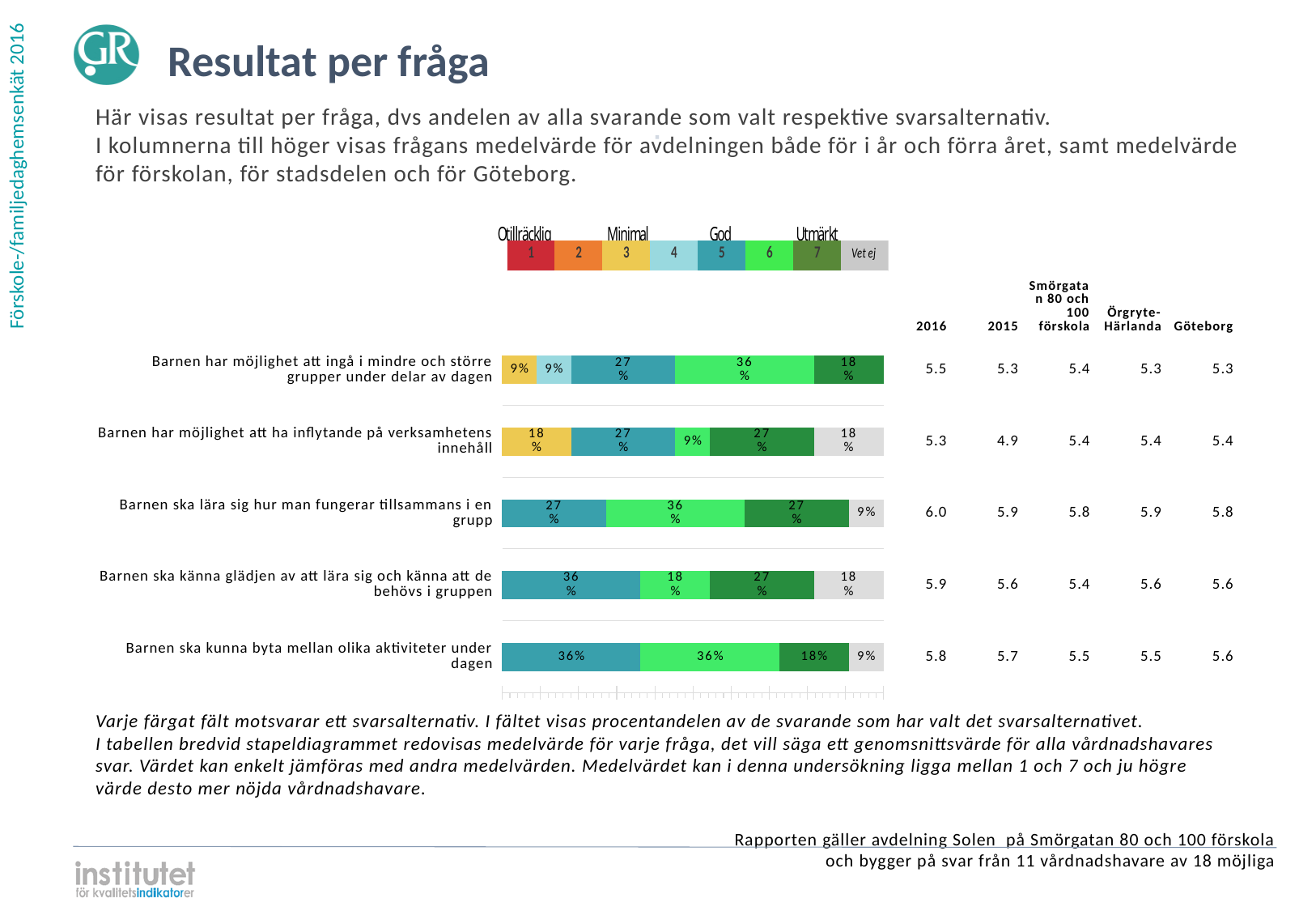
How many questions (bars) are shown in the chart? 5 What is the difference between the 2016 and 2015 mean values for 'Barnen har möjlighet att ha inflytande på verksamhetens innehåll'? 0.4 What is the 2016 mean value for 'Barnen ska lära sig hur man fungerar tillsammans i en grupp'? 6.0 What percentage of respondents chose answer 6 (light green) for 'Barnen har möjlighet att ingå i mindre och större grupper under delar av dagen'? 36% What kind of chart is shown on the slide? Stacked horizontal bar chart How many answer categories does the legend above the chart list? 8 What percentage chose answer 7 (dark green) for 'Barnen ska kunna byta mellan olika aktiviteter under dagen'? 18% What percentage chose 'Vet ej' for 'Barnen har möjlighet att ha inflytande på verksamhetens innehåll'? 18% What is the Göteborg mean value for 'Barnen ska kunna byta mellan olika aktiviteter under dagen'? 5.6 Which question has the highest 2016 mean value? Barnen ska lära sig hur man fungerar tillsammans i en grupp Which question has the lowest 2016 mean value? Barnen har möjlighet att ha inflytande på verksamhetens innehåll For 'Barnen ska känna glädjen av att lära sig och känna att de behövs i gruppen', which is larger: the share choosing answer 5 or the share choosing answer 7? Answer 5 (36%)